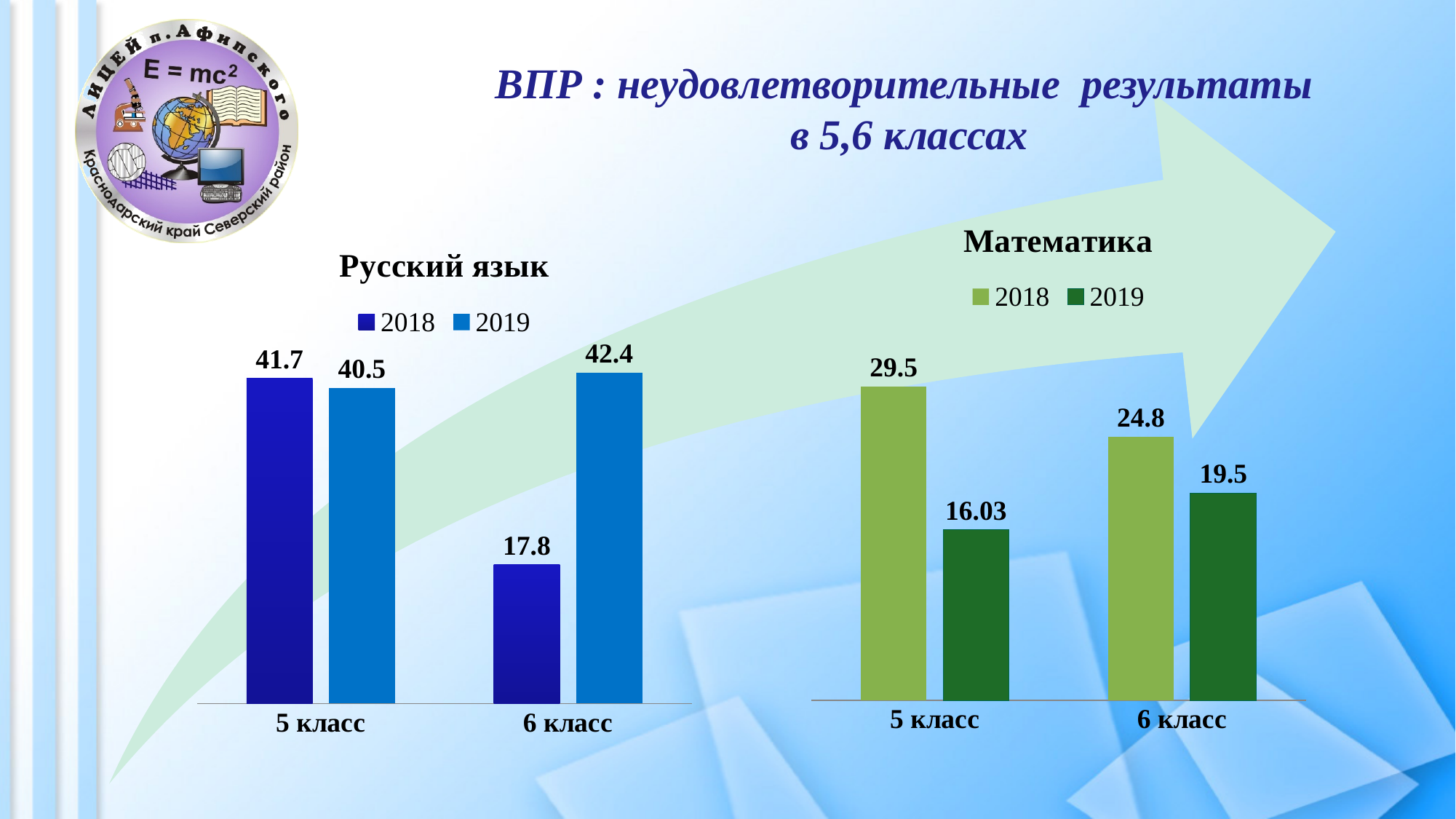
In the "Русский язык" chart, what is the value for 2018 in 5 класс? 41.7 In the "Русский язык" chart, what is the value for 2019 in 6 класс? 42.4 How many categories are shown on the x axis of the "Математика" chart? 2 In the "Математика" chart, which is larger for 6 класс: 2018 or 2019? 2018 In the "Математика" chart, which bar is the highest? 2018, 5 класс (29.5) In the "Русский язык" chart, which bar is the lowest? 2018, 6 класс (17.8) How many series does the legend of the "Русский язык" chart list? 2 In the "Математика" chart, what is the difference between the 2018 and 2019 values for 5 класс? 13.47 In the "Математика" chart, what is the value for 2018 in 6 класс? 24.8 What type of chart is the "Математика" chart? Bar chart In the "Математика" chart, what is the value for 2019 in 5 класс? 16.03 In the "Русский язык" chart, what is the difference between the 2019 and 2018 values for 6 класс? 24.6